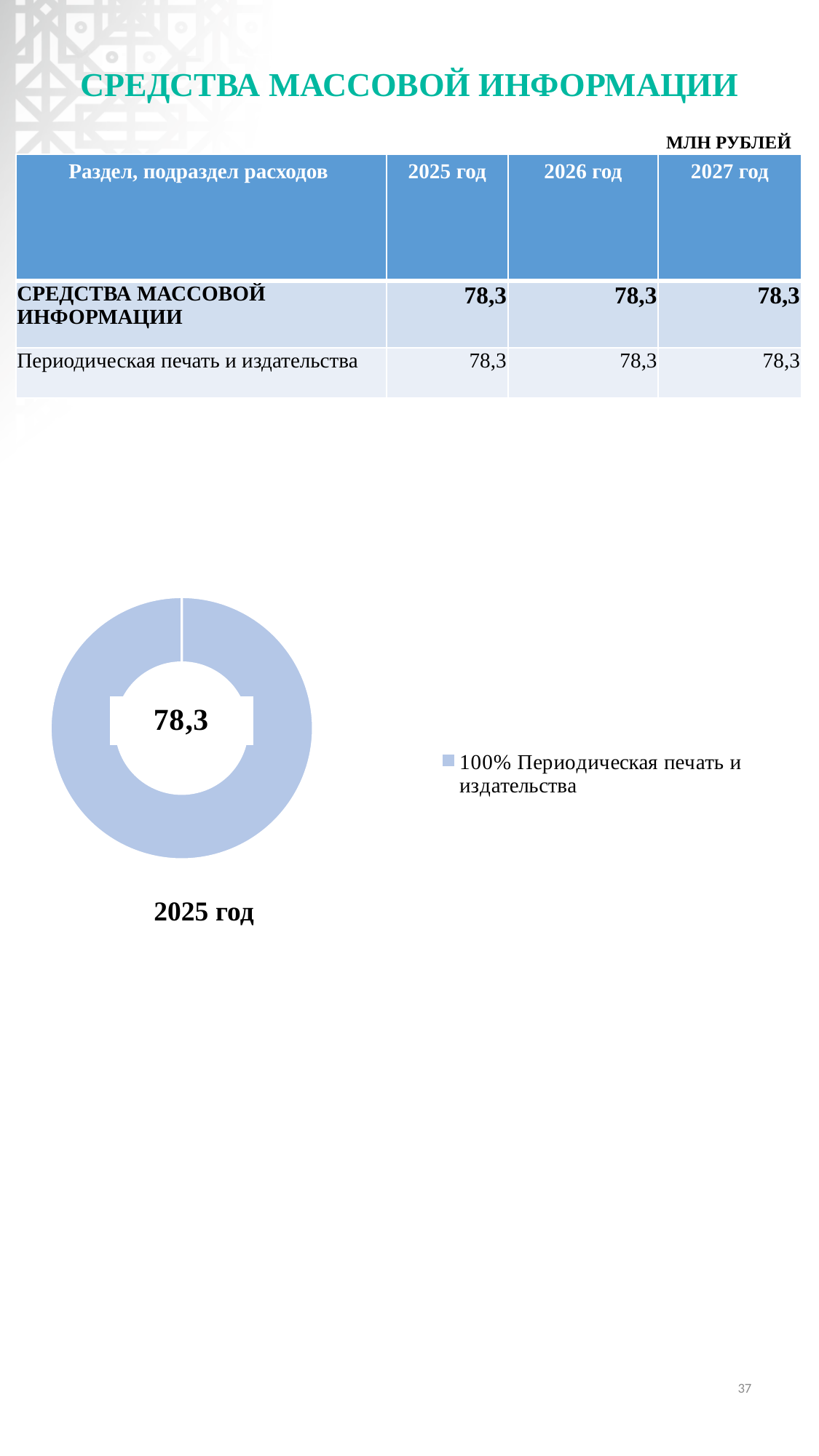
What is the name of the only category in the doughnut chart's legend? Периодическая печать и издательства What value is printed in the centre of the doughnut chart? 78,3 What kind of chart is shown on the slide? doughnut (pie) chart Is the value shown in the centre of the doughnut chart greater or less than 50? greater What share of the doughnut chart does "Периодическая печать и издательства" take? 100% Is the value shown in the centre of the doughnut chart greater or less than 100? less Which year is the doughnut chart labelled with? 2025 год How many slices does the doughnut chart have? 1 How many entries does the legend of the doughnut chart list? 1